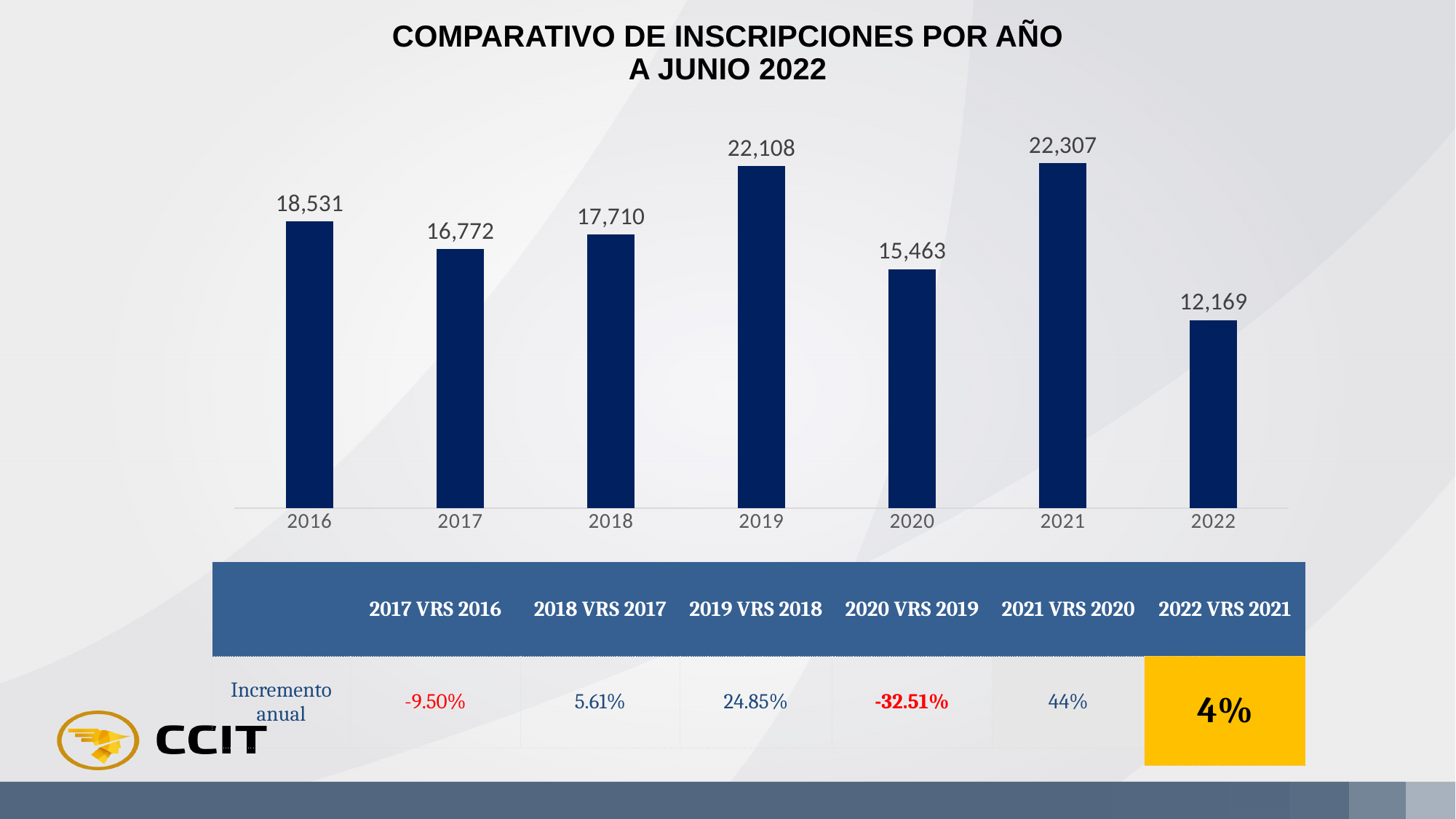
What is the value for 2016? 18,531 What is the difference between the values for 2019 and 2018? 4,398 What is the difference between the values for 2021 and 2020? 6,844 What is the value for 2022? 12,169 How many years are shown in the chart? 7 Which year has the lowest value? 2022 What is the title of the chart? COMPARATIVO DE INSCRIPCIONES POR AÑO A JUNIO 2022 Which year has the highest value? 2021 Does the value rise or fall from 2019 to 2020? Fall Which is larger, the value for 2017 or the value for 2018? 2018 What kind of chart is shown on the slide? Bar chart What is the value for 2019? 22,108